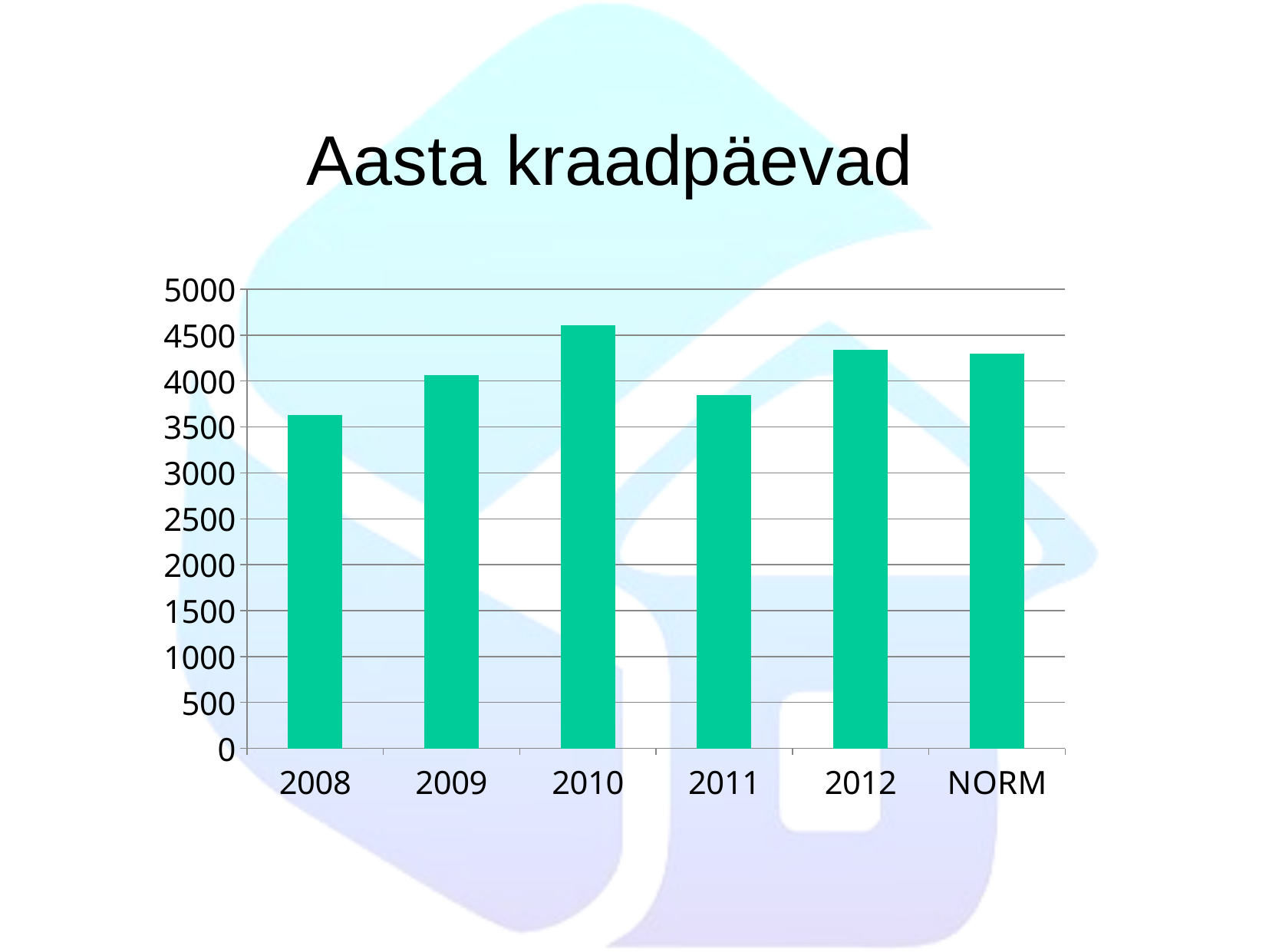
Which is larger, the value for 2010 or the value for 2011? 2010 Which is larger, the value for 2008 or the value for 2009? 2009 What is the highest value shown on the vertical axis of the chart? 5000 What is the title of the chart? Aasta kraadpäevad Is the value for 2010 greater or less than 4500? greater What kind of chart is shown on the slide? bar chart Which category has the highest value in the chart? 2010 Which category has the lowest value in the chart? 2008 Is the value for 2008 greater or less than 4000? less Is the value for 2011 greater or less than 3500? greater How many categories are shown on the x axis of the chart? 6